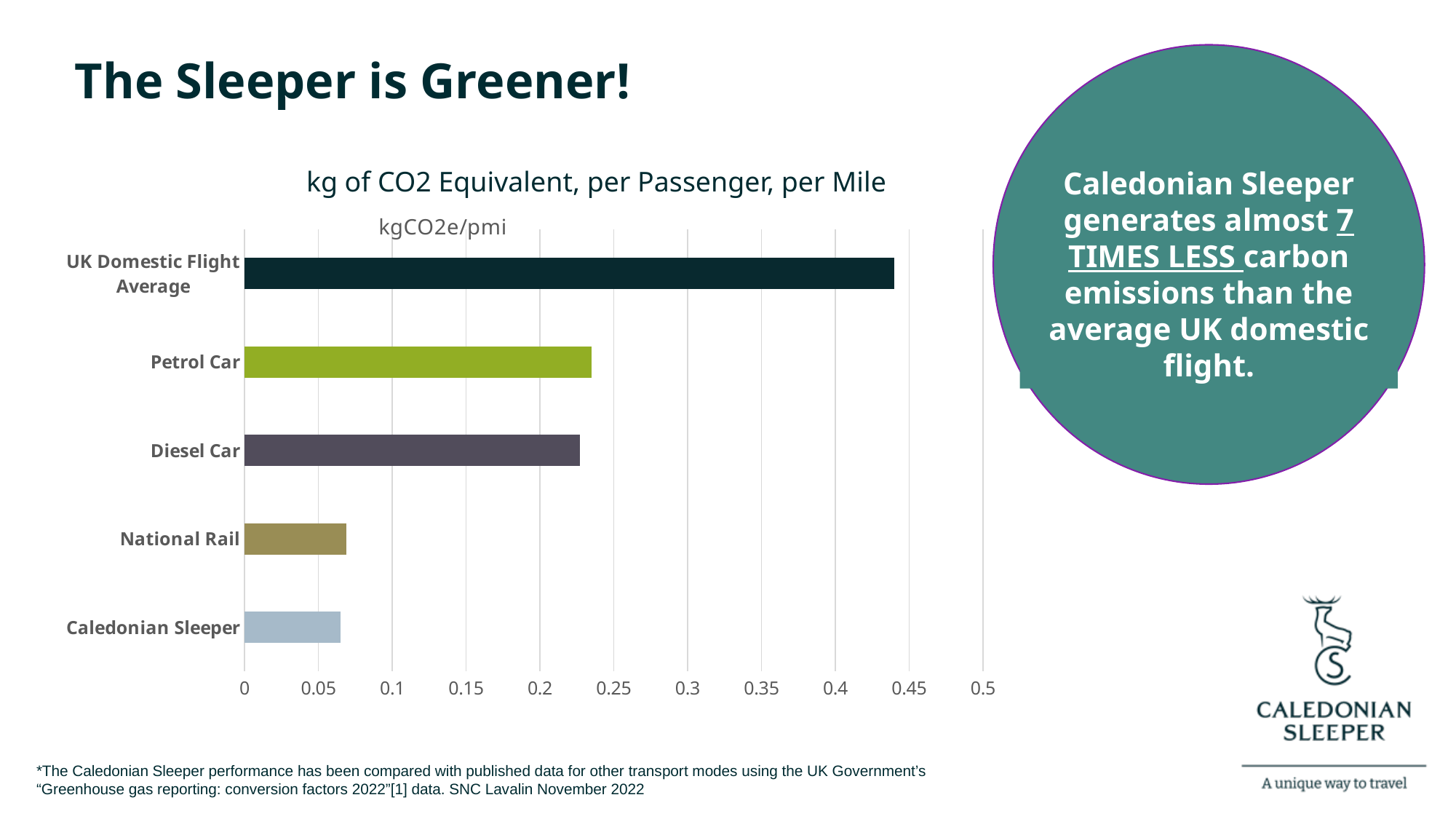
What kind of chart is shown on the slide? bar chart Is the value for National Rail greater or less than 0.1? less Which transport mode has the highest kg of CO2 equivalent per passenger per mile? UK Domestic Flight Average Is the value for Petrol Car greater or less than 0.25? less Which has a higher value, Diesel Car or National Rail? Diesel Car Is the value for Caledonian Sleeper greater or less than 0.1? less Which has a higher value, UK Domestic Flight Average or Petrol Car? UK Domestic Flight Average What is the title of the chart? kg of CO2 Equivalent, per Passenger, per Mile How many transport modes are plotted in the chart? 5 What unit label is shown above the chart's plot area? kgCO2e/pmi